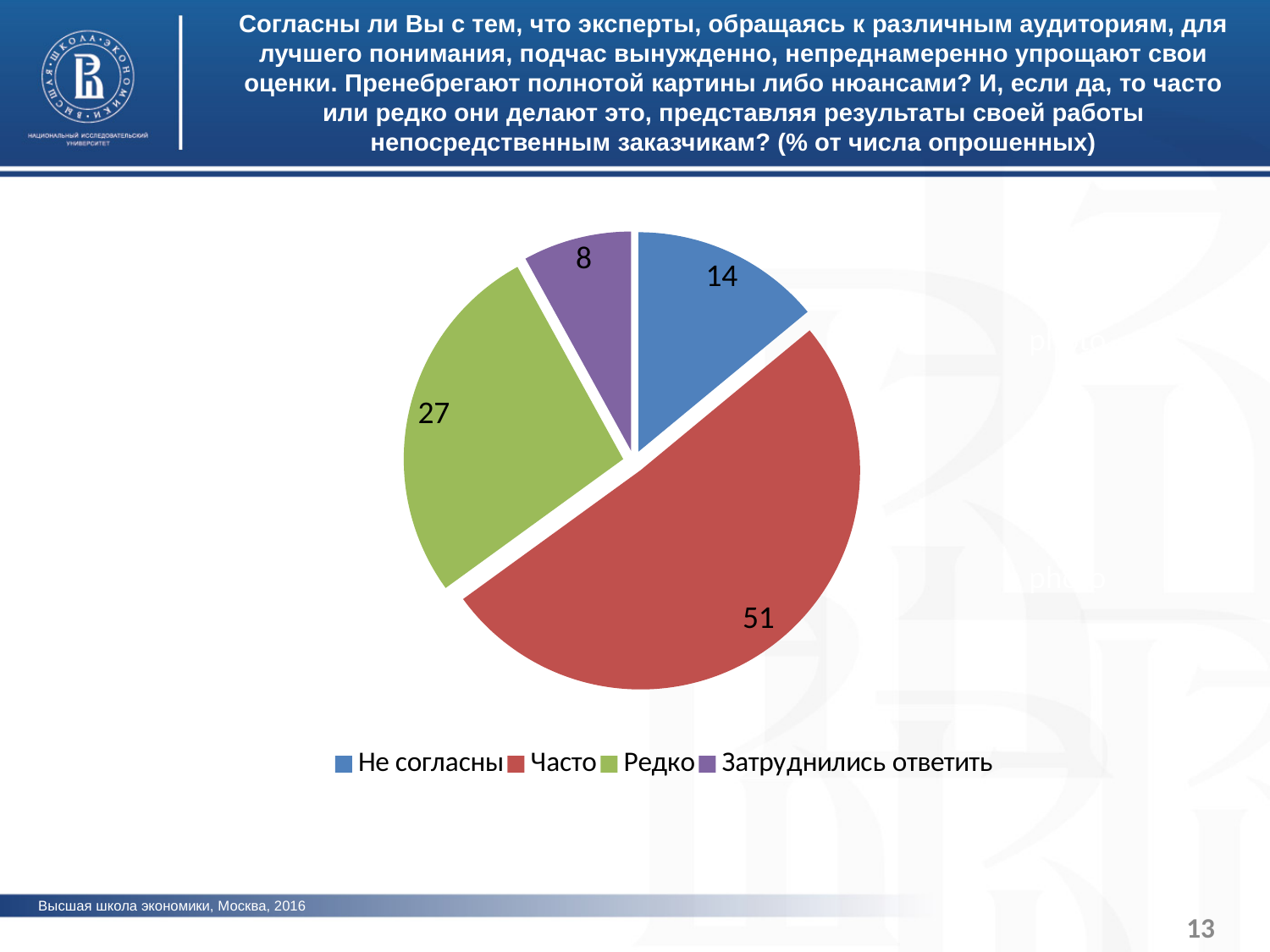
What type of chart is shown on the slide? pie chart What is the combined value of "Часто" and "Редко"? 78 What is the value for "Не согласны"? 14 Which is larger, the value for "Не согласны" or the value for "Затруднились ответить"? Не согласны What is the difference between the values for "Часто" and "Редко"? 24 How many categories does the pie chart show? 4 Which category has the largest slice? Часто What is the value for "Часто"? 51 Which category has the smallest slice? Затруднились ответить What is the value for "Редко"? 27 What colour is the slice for "Редко"? green What is the value for "Затруднились ответить"? 8